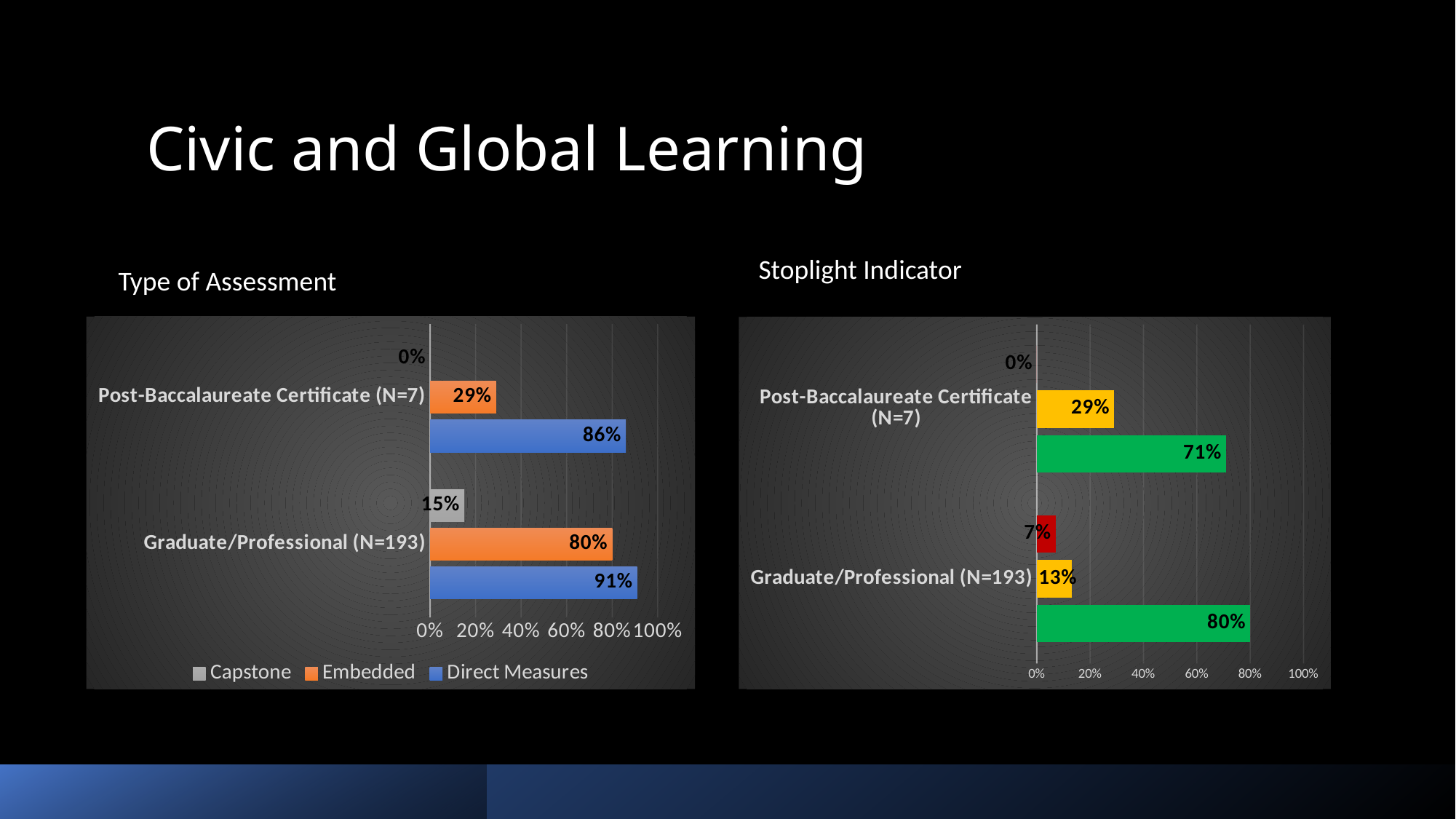
In the Type of Assessment chart, what is the Capstone value for Graduate/Professional (N=193)? 15% In the Stoplight Indicator chart, which is larger for Graduate/Professional (N=193): the yellow bar or the red bar? The yellow bar In the Type of Assessment chart, which series has the lowest value for Post-Baccalaureate Certificate (N=7)? Capstone In the Type of Assessment chart, what is the difference between the Direct Measures values for Graduate/Professional (N=193) and Post-Baccalaureate Certificate (N=7)? 5% In the Stoplight Indicator chart, what is the difference between the green bar values for Graduate/Professional (N=193) and Post-Baccalaureate Certificate (N=7)? 9% How many series does the legend of the Type of Assessment chart list? 3 In the Stoplight Indicator chart, what is the value of the green bar for Post-Baccalaureate Certificate (N=7)? 71% How many categories are shown in the Stoplight Indicator chart? 2 What kind of chart is the Stoplight Indicator chart? Bar chart In the Type of Assessment chart, what is the Direct Measures value for Graduate/Professional (N=193)? 91% In the Type of Assessment chart, what is the Embedded value for Post-Baccalaureate Certificate (N=7)? 29% In the Stoplight Indicator chart, what is the value of the red bar for Graduate/Professional (N=193)? 7%